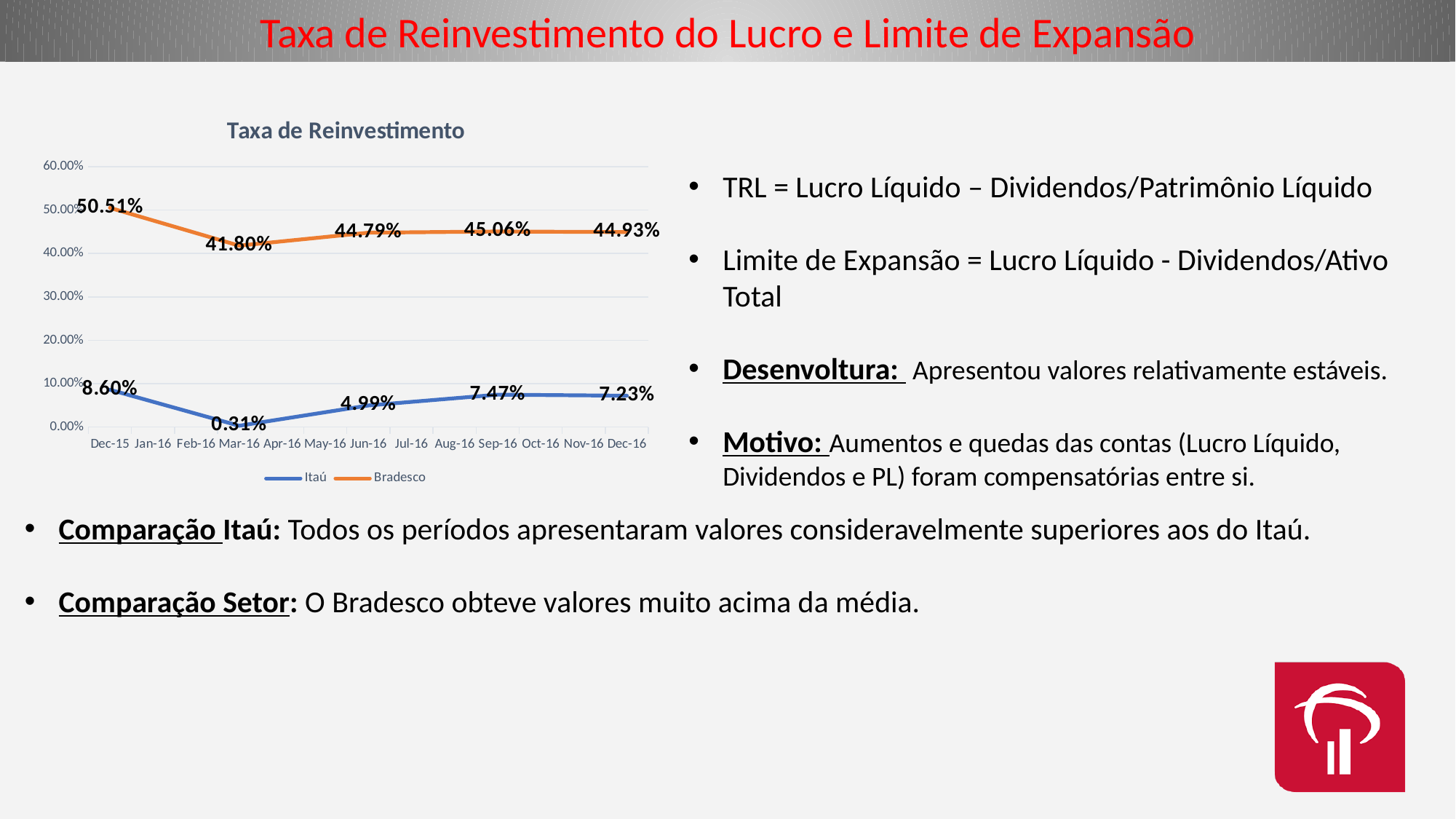
What is the Bradesco value for Sep-16 in the Taxa de Reinvestimento chart? 45.06% What type of chart is shown on the slide? line chart In which period does Bradesco reach its lowest value in the Taxa de Reinvestimento chart? Mar-16 Is the Bradesco value for Mar-16 greater or less than 40.00% in the Taxa de Reinvestimento chart? greater Which series has the larger value in Jun-16 in the Taxa de Reinvestimento chart, Itaú or Bradesco? Bradesco What is the Itaú value for Mar-16 in the Taxa de Reinvestimento chart? 0.31% What is the difference between the Bradesco and Itaú values for Dec-15 in the Taxa de Reinvestimento chart? 41.91% In which period does Itaú reach its highest value in the Taxa de Reinvestimento chart? Dec-15 How many series does the legend of the Taxa de Reinvestimento chart list? 2 What is the Itaú value for Dec-16 in the Taxa de Reinvestimento chart? 7.23% What is the Bradesco value for Dec-15 in the Taxa de Reinvestimento chart? 50.51% Which series is drawn in orange in the Taxa de Reinvestimento chart? Bradesco